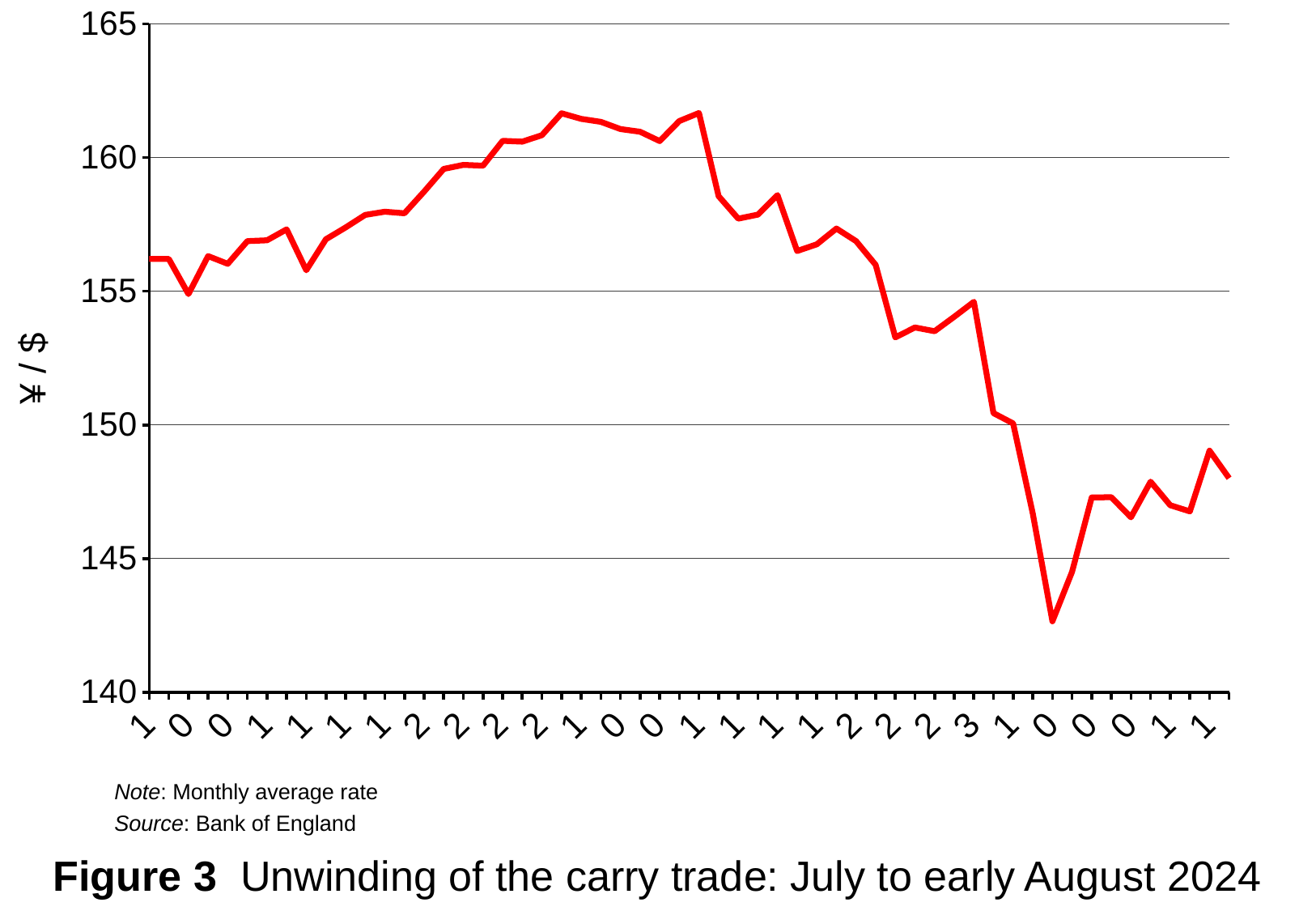
What is the lowest value shown on the vertical axis? 140 What kind of chart is shown on the slide? line chart What is the label on the vertical axis of the chart? ¥ / $ How many lines are plotted on the chart? 1 Is the lowest point on the line greater or less than 145? less Is the first value on the line greater or less than 155? greater Is the last value on the line greater or less than 150? less Overall, does the line rise or fall from the left end of the x axis to the right end? fall Which is higher, the first value on the line or the last value on the line? the first value What is the title of the figure on the slide? Figure 3 Unwinding of the carry trade: July to early August 2024